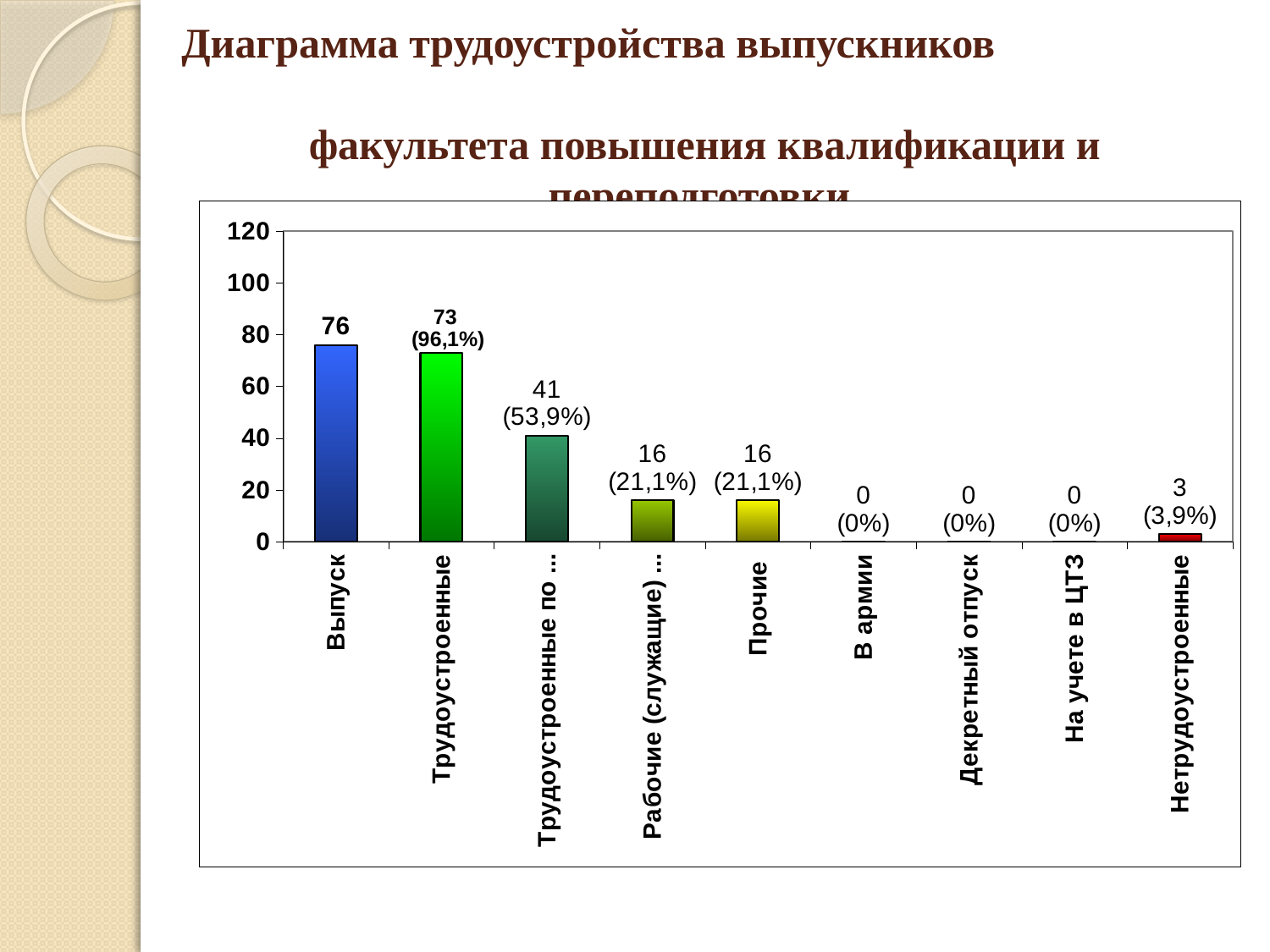
What is the value for Трудоустроенные? 73 Is the value for Выпуск greater or less than 60? greater What percentage is shown for Нетрудоустроенные? 3,9% What kind of chart is shown on the slide? bar chart What percentage is shown for Трудоустроенные? 96,1% What is the value for Нетрудоустроенные? 3 Which category has the highest value? Выпуск Which is larger, the value for Прочие or the value for Нетрудоустроенные? Прочие What is the value for В армии? 0 What is the value for Выпуск? 76 How many categories are shown on the x axis? 9 What is the difference between the values for Выпуск and Трудоустроенные? 3